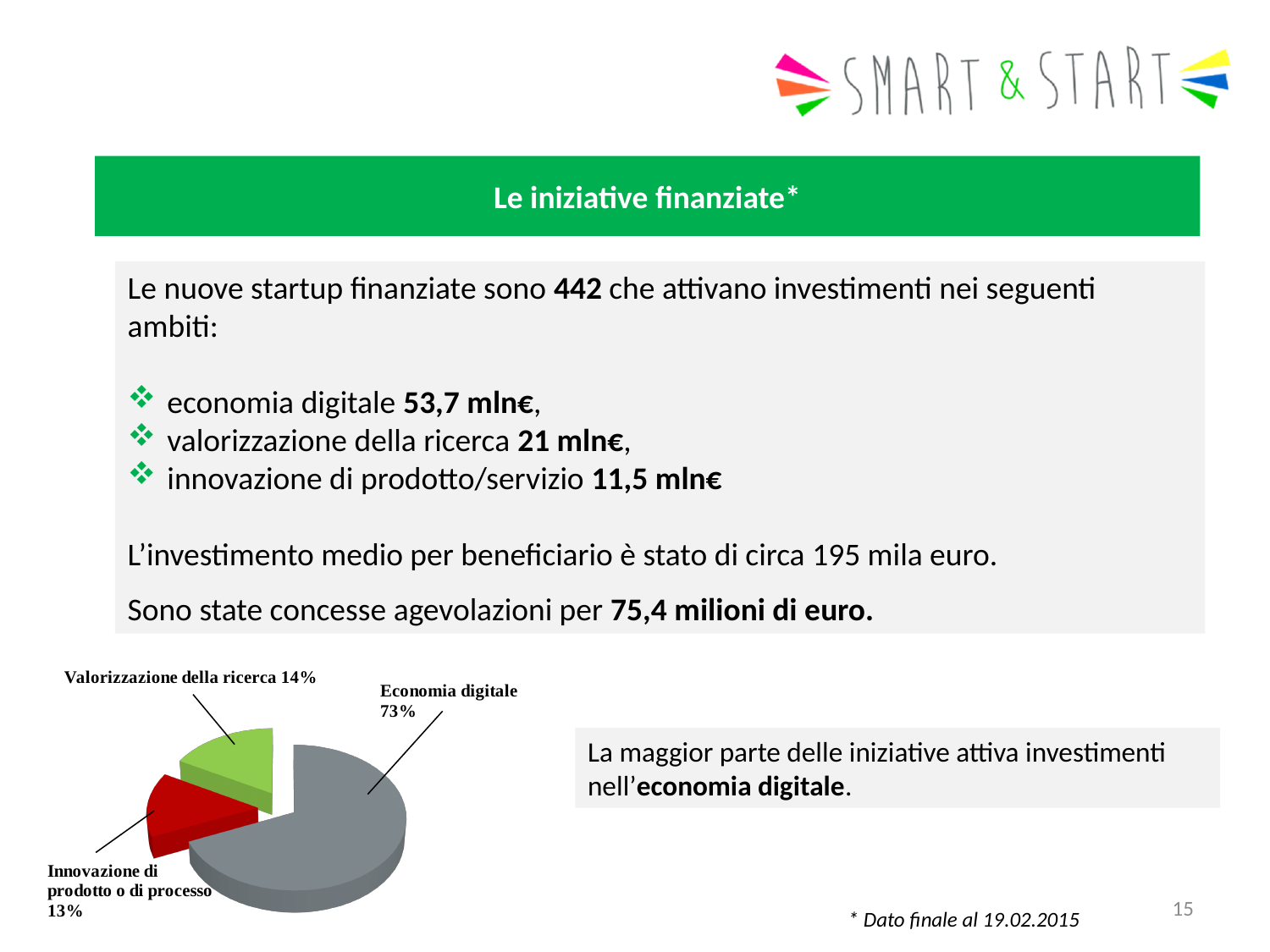
What share of the pie does Economia digitale represent? 73% What kind of chart is shown on the slide? pie chart Which slice of the pie chart is the smallest? Innovazione di prodotto o di processo Which is larger in the pie chart, Valorizzazione della ricerca or Innovazione di prodotto o di processo? Valorizzazione della ricerca What colour is the Valorizzazione della ricerca slice of the pie chart? green What is the difference in percentage points between Economia digitale and Valorizzazione della ricerca? 59 How many slices does the pie chart have? 3 What share of the pie does Valorizzazione della ricerca represent? 14% What colour is the Economia digitale slice of the pie chart? grey Which slice of the pie chart is the largest? Economia digitale What share of the pie does Innovazione di prodotto o di processo represent? 13% What is the difference in percentage points between Valorizzazione della ricerca and Innovazione di prodotto o di processo? 1